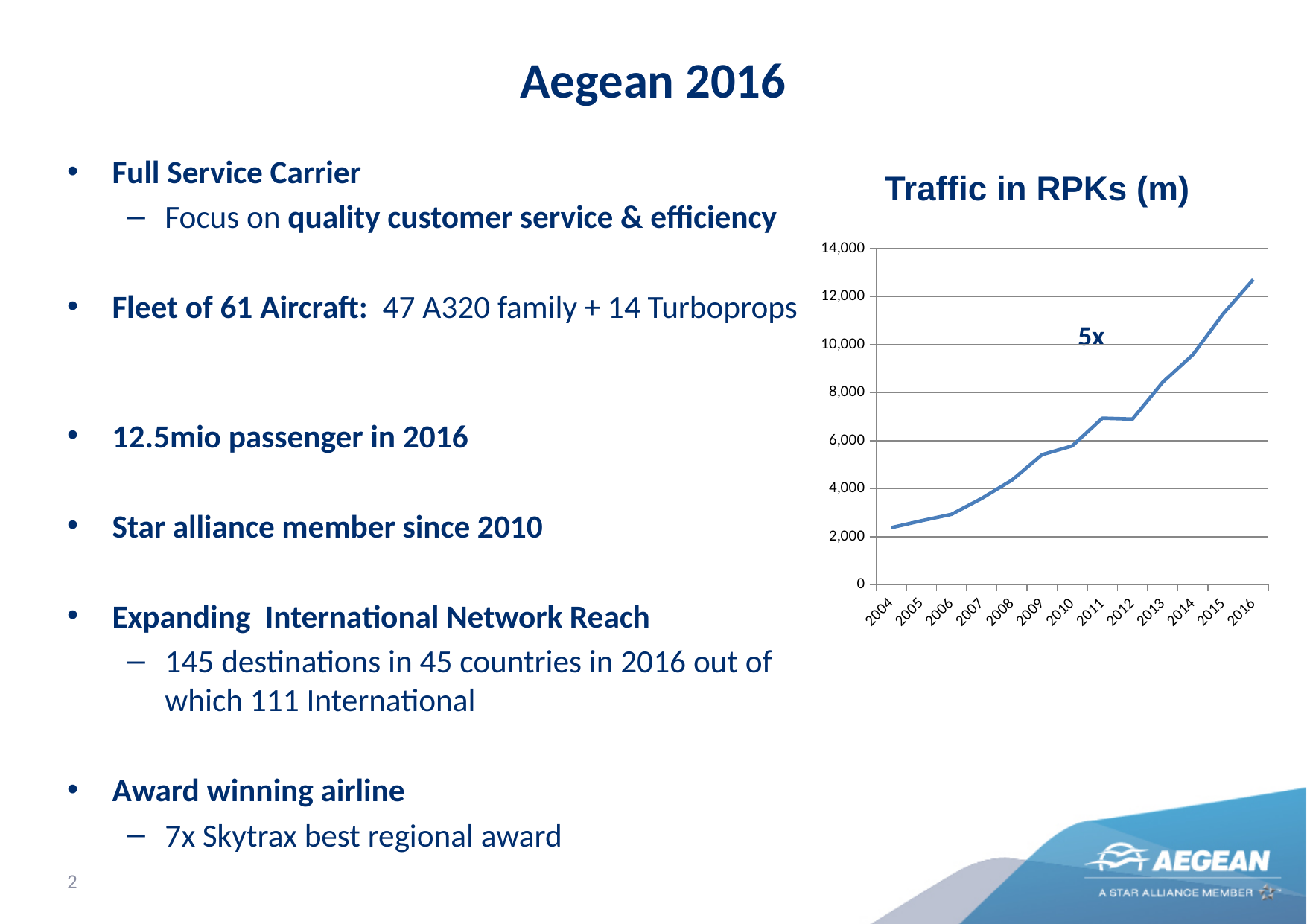
What annotation is written next to the line in the chart? 5x Which year has the larger value, 2015 or 2011? 2015 How many years are plotted on the x axis of the chart? 13 What kind of chart is shown on the slide? line chart Is the value for 2016 greater or less than 12,000? greater Which year has the lowest traffic in RPKs? 2004 Do the values in the chart generally rise or fall from 2004 to 2016? rise What is the title of the chart? Traffic in RPKs (m) Is the value for 2010 greater or less than 8,000? less Is the value for 2004 greater or less than 4,000? less Which year has the highest traffic in RPKs? 2016